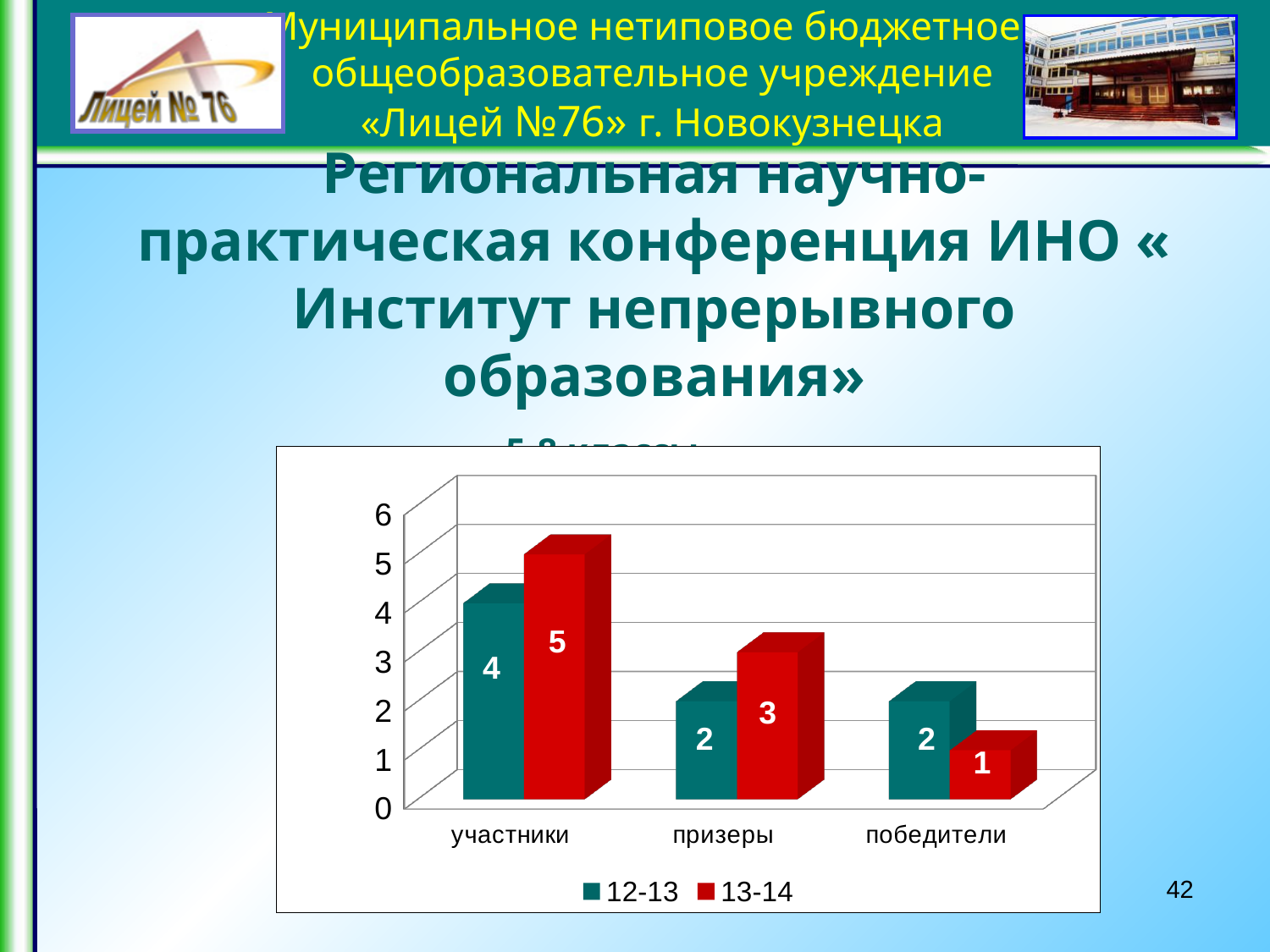
For победители, which series has the larger value, 12-13 or 13-14? 12-13 What is the value for участники in the 12-13 series? 4 What is the value for призеры in the 13-14 series? 3 Which colour represents the 13-14 series in the chart? red How many series does the legend list? 2 Which category has the highest value in the 13-14 series? участники How many categories are shown on the x axis? 3 What is the difference between the 13-14 and 12-13 values for участники? 1 Which category has the lowest value in the 13-14 series? победители What kind of chart is shown on the slide? bar chart What is the value for участники in the 13-14 series? 5 What is the value for победители in the 12-13 series? 2